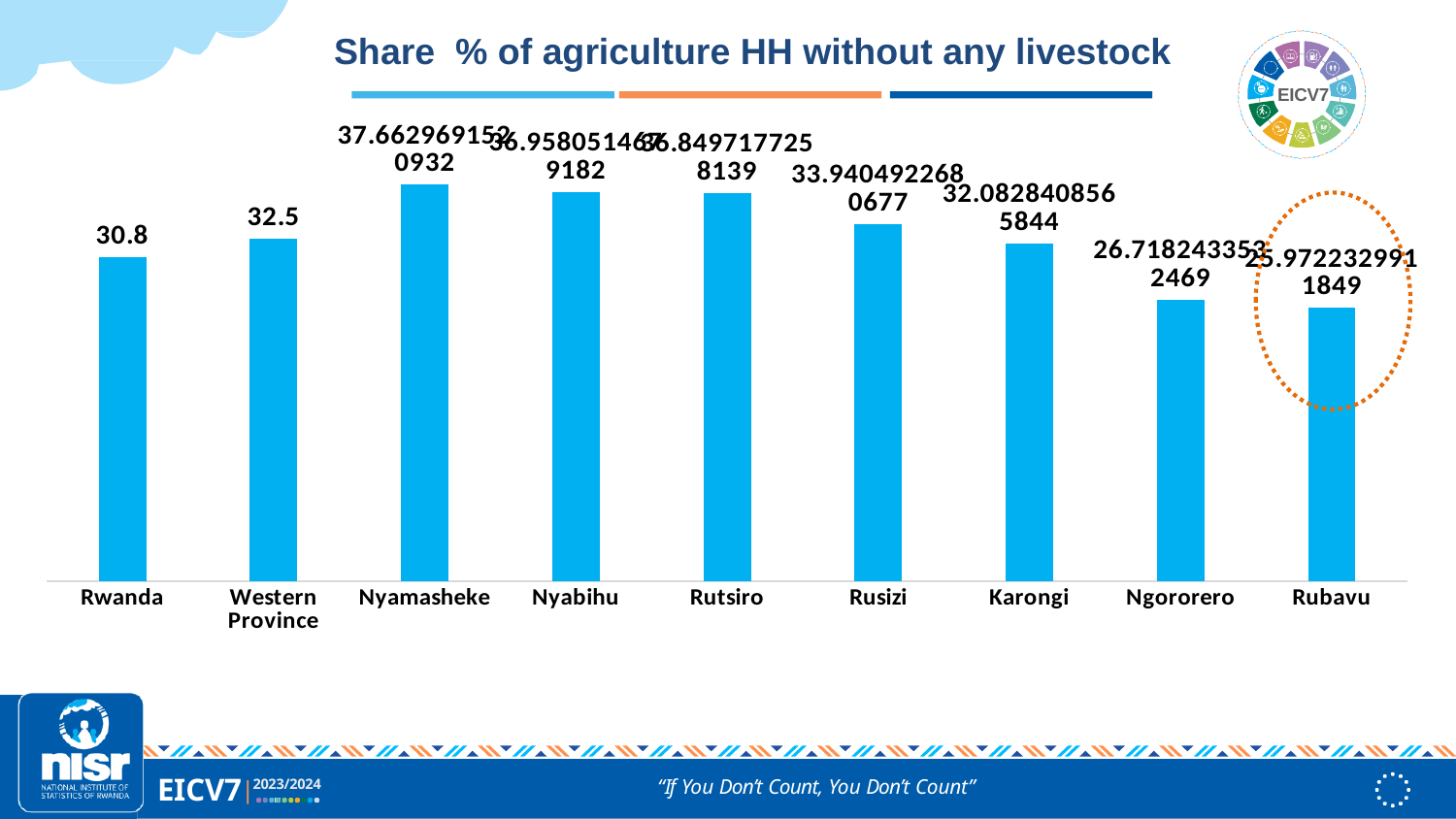
What is the value shown for Karongi? 32.0828408565844 Which category's bar is highlighted with a dotted orange circle? Rubavu Do the values rise or fall from Nyamasheke to Rubavu along the x axis? Fall What is the value for Western Province? 32.5 What kind of chart is shown on the slide? Bar chart Which category has the highest share of agriculture households without any livestock? Nyamasheke What is the difference between the values for Western Province and Rwanda? 1.7 Which is larger, the value for Rwanda or the value for Western Province? Western Province How many categories are shown on the x axis? 9 What is the value shown for Rusizi? 33.9404922680677 What is the value for Rwanda? 30.8 Which category has the lowest share of agriculture households without any livestock? Rubavu